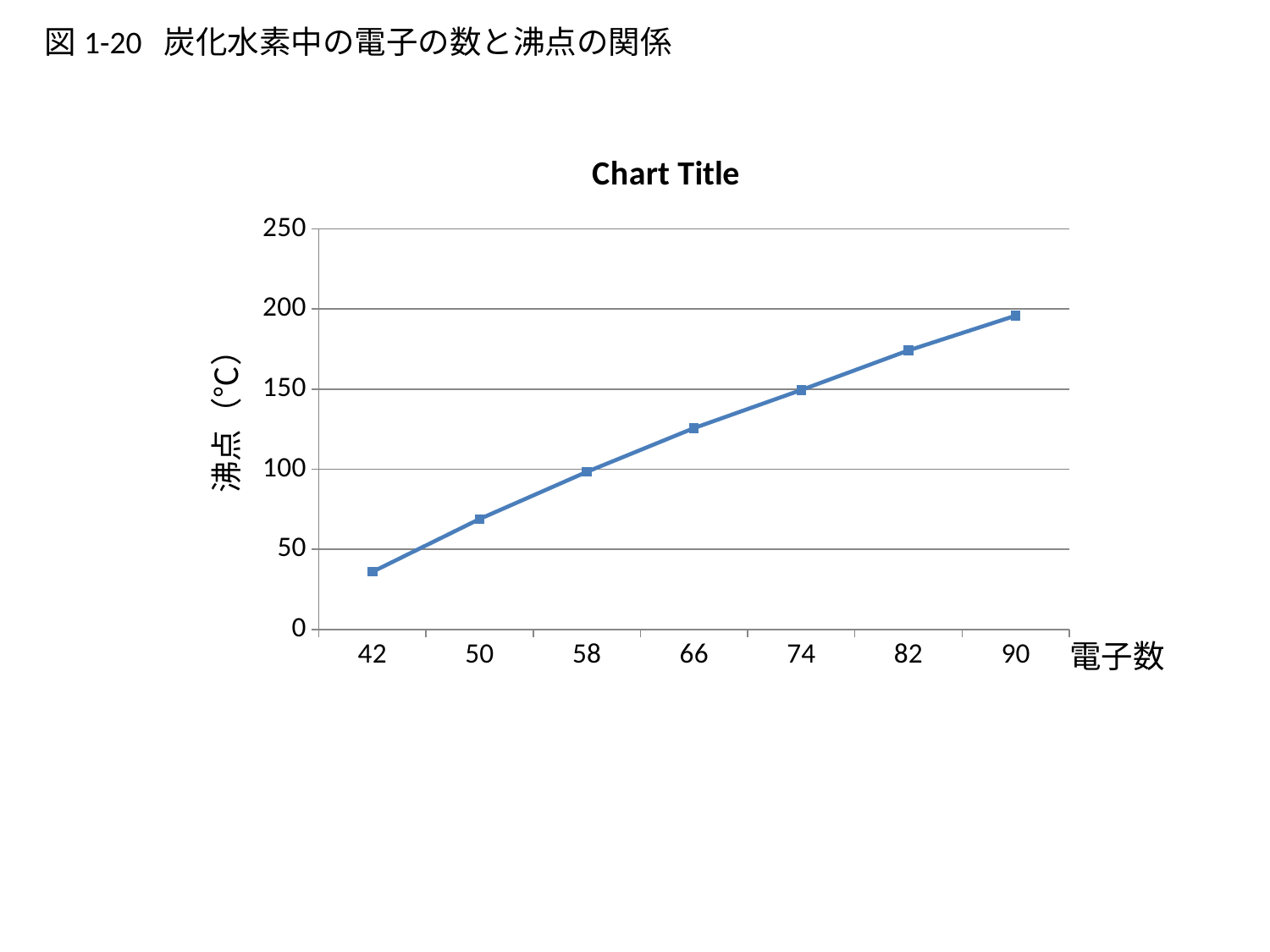
Is the boiling point at 50 electrons greater or less than 50? greater What kind of chart is shown on the slide? line chart Is the boiling point at 90 electrons greater or less than 200? less At which electron count (電子数) is the boiling point lowest? 42 Is the boiling point at 42 electrons greater or less than 50? less At which electron count (電子数) is the boiling point highest? 90 Which has the higher boiling point, 58 electrons or 74 electrons? 74 electrons Do the boiling point values rise or fall as the electron count increases along the x axis? rise What is the label on the vertical axis of the chart? 沸点 (°C) How many data points are plotted on the chart? 7